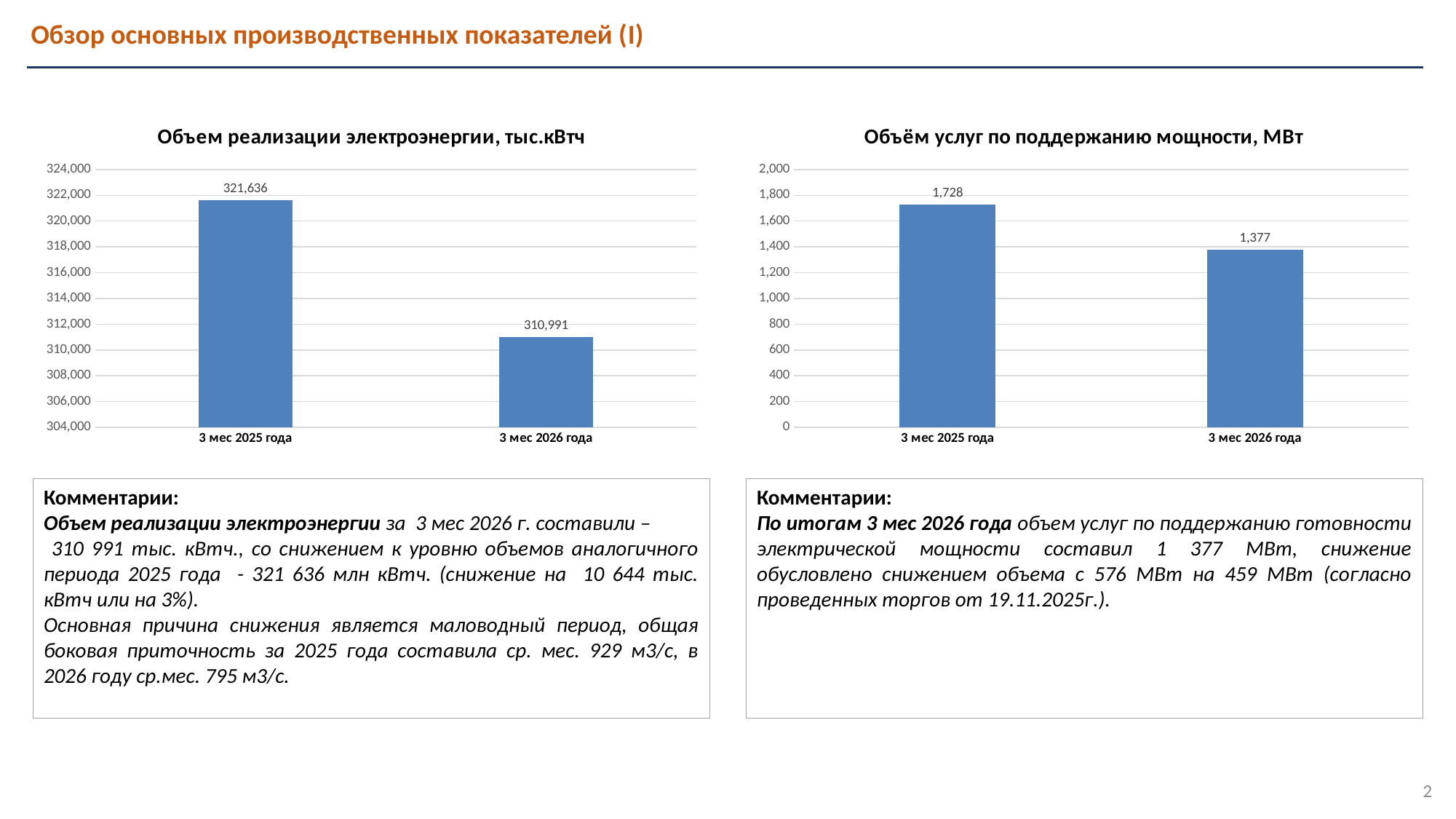
In the chart 'Объём услуг по поддержанию мощности, МВт', what is the value for 3 мес 2025 года? 1,728 In the chart 'Объем реализации электроэнергии, тыс.кВтч', what is the value for 3 мес 2026 года? 310,991 In the chart 'Объём услуг по поддержанию мощности, МВт', what is the value for 3 мес 2026 года? 1,377 In the chart 'Объём услуг по поддержанию мощности, МВт', is the value for 3 мес 2026 года greater or less than 1,400? less In the chart 'Объем реализации электроэнергии, тыс.кВтч', what is the difference between the values for 3 мес 2025 года and 3 мес 2026 года? 10,645 In the chart 'Объем реализации электроэнергии, тыс.кВтч', what is the value for 3 мес 2025 года? 321,636 In the chart 'Объем реализации электроэнергии, тыс.кВтч', do the values rise or fall from 3 мес 2025 года to 3 мес 2026 года? fall In the chart 'Объем реализации электроэнергии, тыс.кВтч', which category has the highest value? 3 мес 2025 года In the chart 'Объём услуг по поддержанию мощности, МВт', what is the difference between the values for 3 мес 2025 года and 3 мес 2026 года? 351 What kind of chart is 'Объём услуг по поддержанию мощности, МВт'? bar chart In the chart 'Объём услуг по поддержанию мощности, МВт', which category has the lowest value? 3 мес 2026 года In the chart 'Объем реализации электроэнергии, тыс.кВтч', how many categories are shown? 2